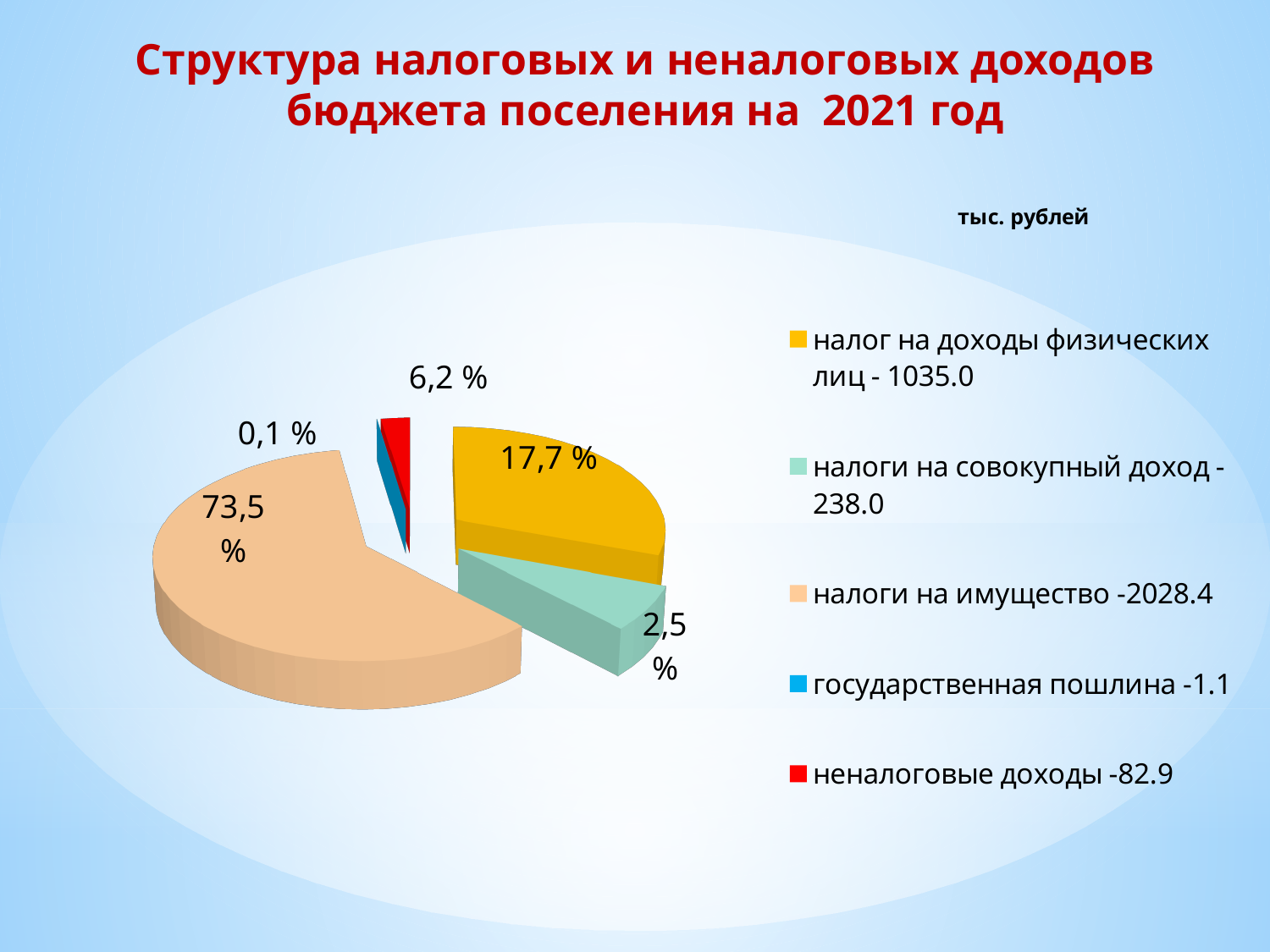
What share of the pie does "налоги на имущество" take? 73,5 % What share of the pie does "налог на доходы физических лиц" take? 17,7 % Which is larger: the share for "налог на доходы физических лиц" or the share for "налоги на совокупный доход"? налог на доходы физических лиц What kind of chart is shown on the slide? pie chart What share of the pie does "государственная пошлина" take? 0,1 % How many slices does the pie chart have? 5 What value (in thousand rubles) does the legend give for "налоги на совокупный доход"? 238.0 What unit is stated above the legend of the chart? тыс. рублей What value (in thousand rubles) does the legend give for "неналоговые доходы"? 82.9 Which category has the largest slice of the pie? налоги на имущество Which category has the smallest slice of the pie? государственная пошлина